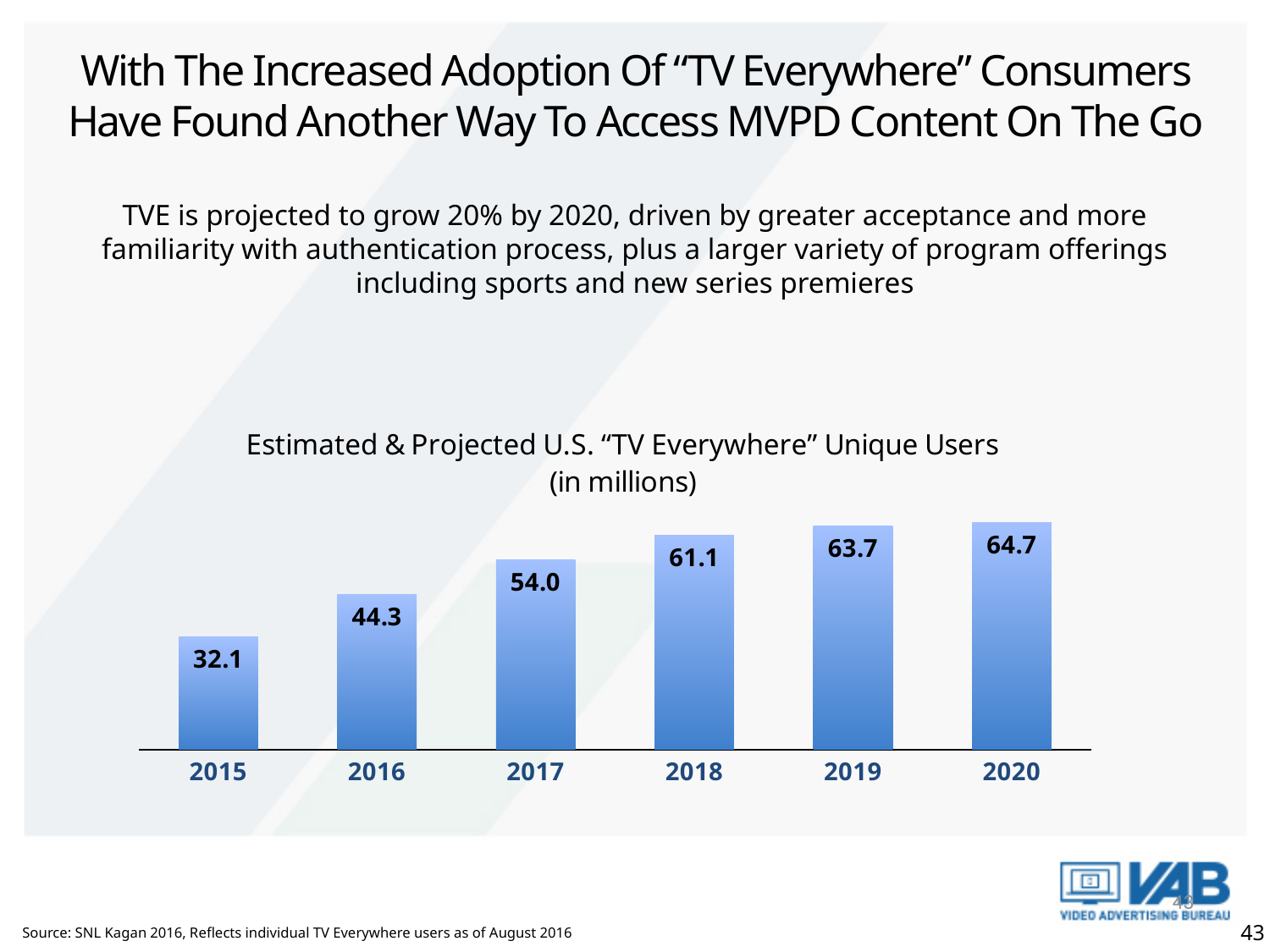
How many years are shown on the chart? 6 What is the difference between the values for 2017 and 2016? 9.7 What is the value for 2018? 61.1 Do the values rise or fall from 2015 to 2020? rise Which is larger, the value for 2017 or the value for 2019? 2019 Which year has the highest value? 2020 What is the title of the chart? Estimated & Projected U.S. "TV Everywhere" Unique Users (in millions) What is the value for 2020? 64.7 What is the difference between the values for 2020 and 2015? 32.6 What is the value for 2015? 32.1 Which year has the lowest value? 2015 What kind of chart is shown? bar chart